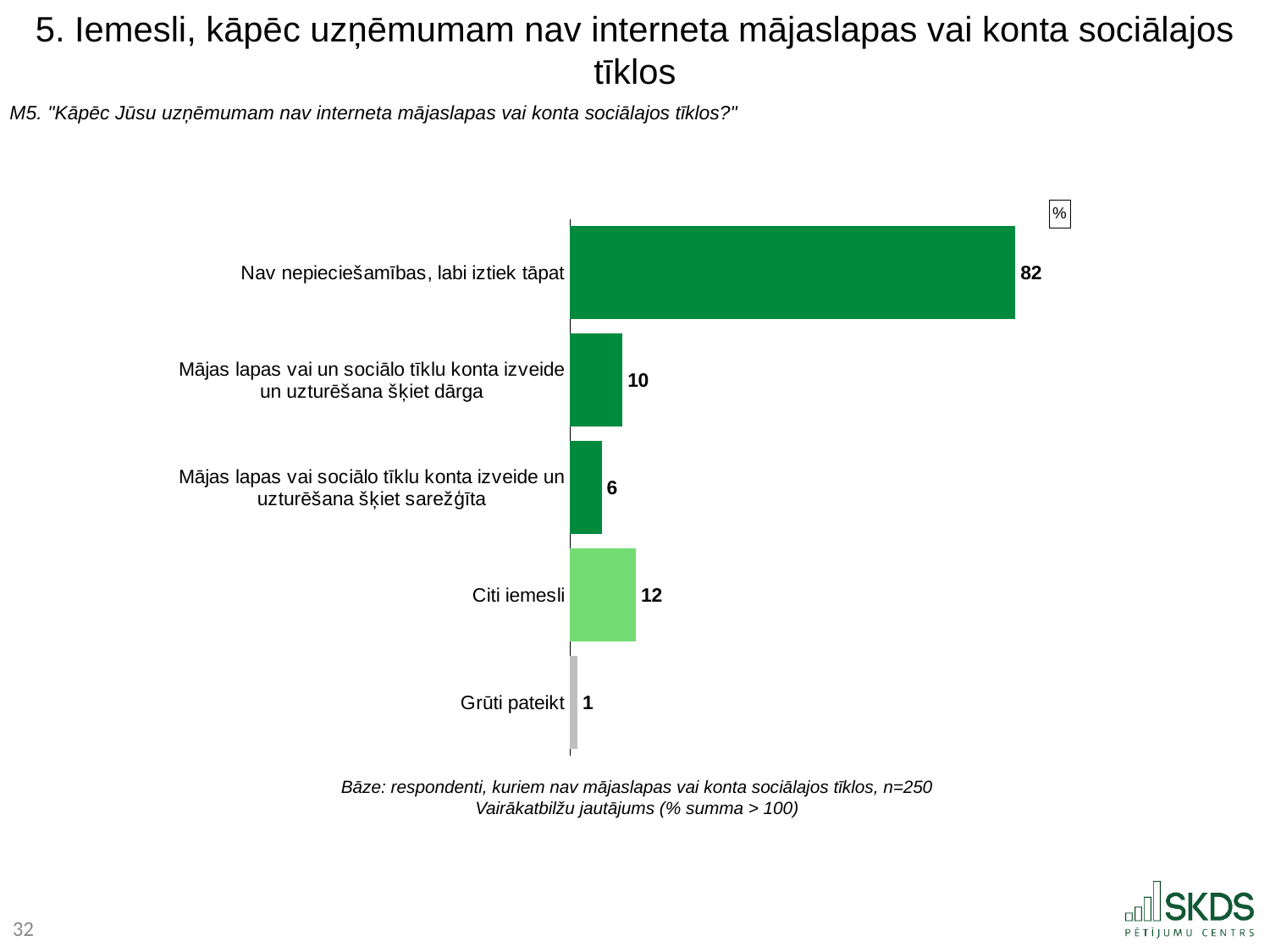
How many categories are shown in the chart? 5 What is the value for "Mājas lapas vai un sociālo tīklu konta izveide un uzturēšana šķiet dārga"? 10 Which category has the lowest value? Grūti pateikt What is the value for "Grūti pateikt"? 1 Which category has the highest value? Nav nepieciešamības, labi iztiek tāpat Which is larger: the value for "Citi iemesli" or the value for "Mājas lapas vai un sociālo tīklu konta izveide un uzturēšana šķiet dārga"? Citi iemesli What is the difference between the values for "Mājas lapas vai un sociālo tīklu konta izveide un uzturēšana šķiet dārga" and "Mājas lapas vai sociālo tīklu konta izveide un uzturēšana šķiet sarežģīta"? 4 What is the value for "Citi iemesli"? 12 What kind of chart is shown on the slide? Bar chart What is the difference between the values for "Nav nepieciešamības, labi iztiek tāpat" and "Citi iemesli"? 70 What is the value for "Nav nepieciešamības, labi iztiek tāpat"? 82 What is the base size (n) stated below the chart? n=250